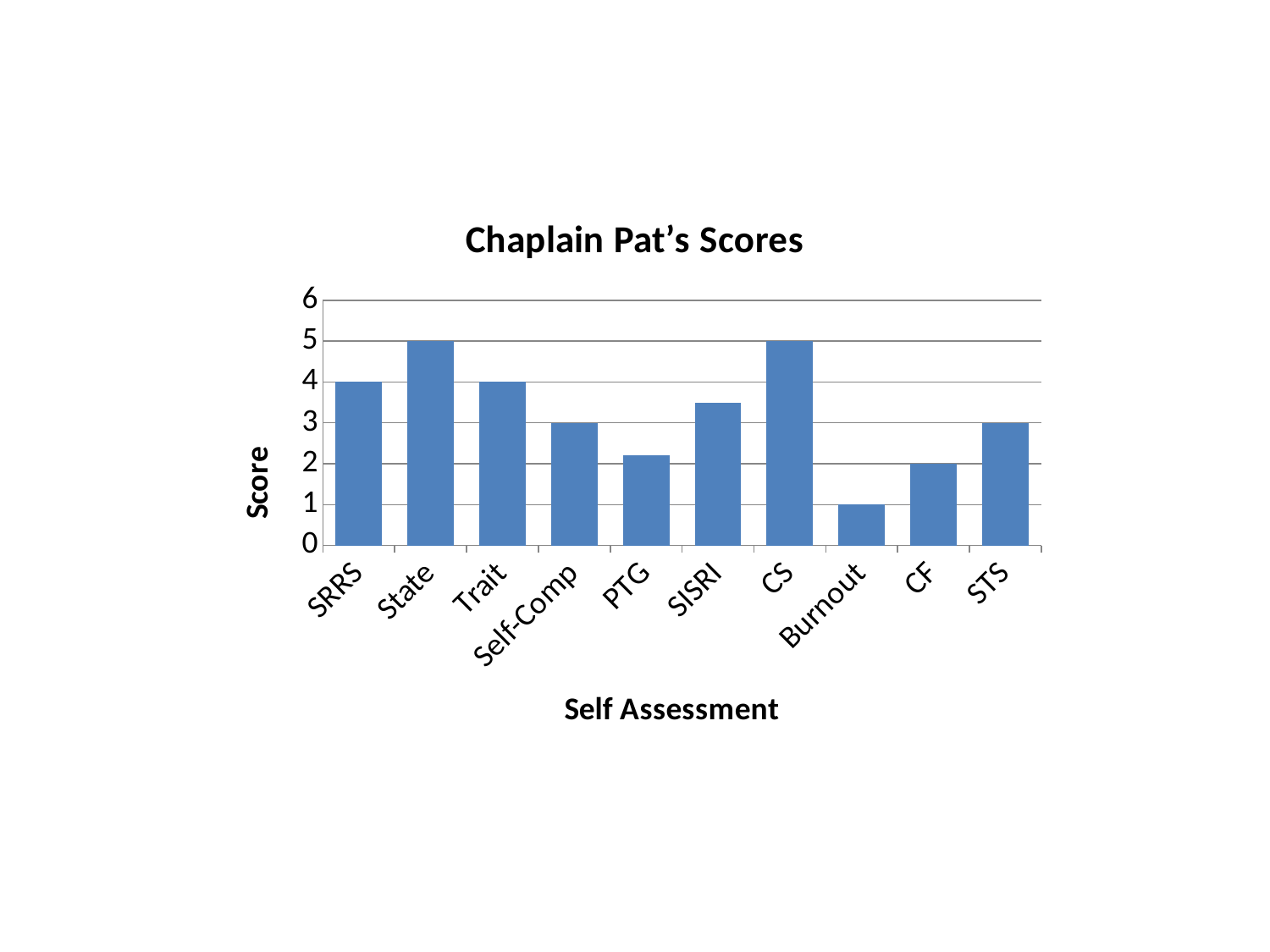
What type of chart is shown on the slide? bar chart What is the score for SRRS? 4 What is the score for CF? 2 Is the score for PTG greater or less than 3? less How many categories are shown on the x axis of the chart? 10 What is the title of the chart? Chaplain Pat's Scores Is the score for SISRI greater or less than 3? greater What is the score for Burnout? 1 What is the score for State? 5 What is the difference between the scores for CS and Burnout? 4 Which has a higher score, Trait or Self-Comp? Trait Which category has the lowest score? Burnout